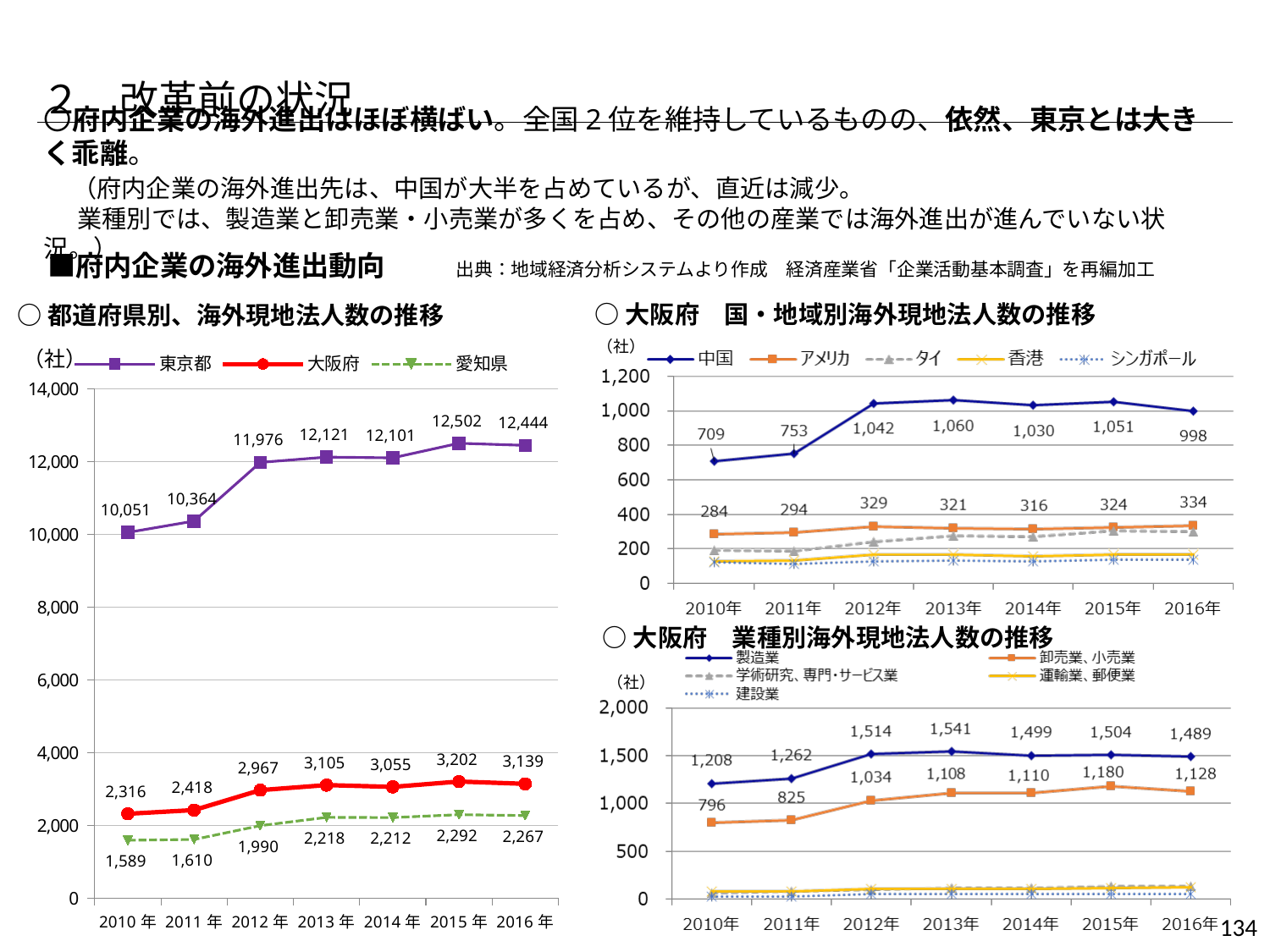
In the chart titled 都道府県別、海外現地法人数の推移, what is the value for 東京都 in 2016年? 12,444 In the chart titled 大阪府 国・地域別海外現地法人数の推移, is the value for 中国 in 2010年 greater or less than 800? less In the chart titled 都道府県別、海外現地法人数の推移, in which year is the value for 愛知県 lowest? 2010年 In the chart titled 都道府県別、海外現地法人数の推移, how many series does the legend list? 3 In the chart titled 都道府県別、海外現地法人数の推移, what is the difference between 東京都 and 大阪府 in 2015年? 9,300 In the chart titled 大阪府 国・地域別海外現地法人数の推移, how many series does the legend list? 5 In the chart titled 大阪府 業種別海外現地法人数の推移, what is the value for 製造業 in 2013年? 1,541 What kind of chart is the chart titled 大阪府 業種別海外現地法人数の推移? line chart In the chart titled 大阪府 業種別海外現地法人数の推移, what is the difference between 製造業 and 卸売業、小売業 in 2010年? 412 In the chart titled 大阪府 国・地域別海外現地法人数の推移, what is the value for 中国 in 2013年? 1,060 In the chart titled 大阪府 国・地域別海外現地法人数の推移, in which year is the value for アメリカ highest? 2016年 In the chart titled 都道府県別、海外現地法人数の推移, what is the value for 大阪府 in 2013年? 3,105